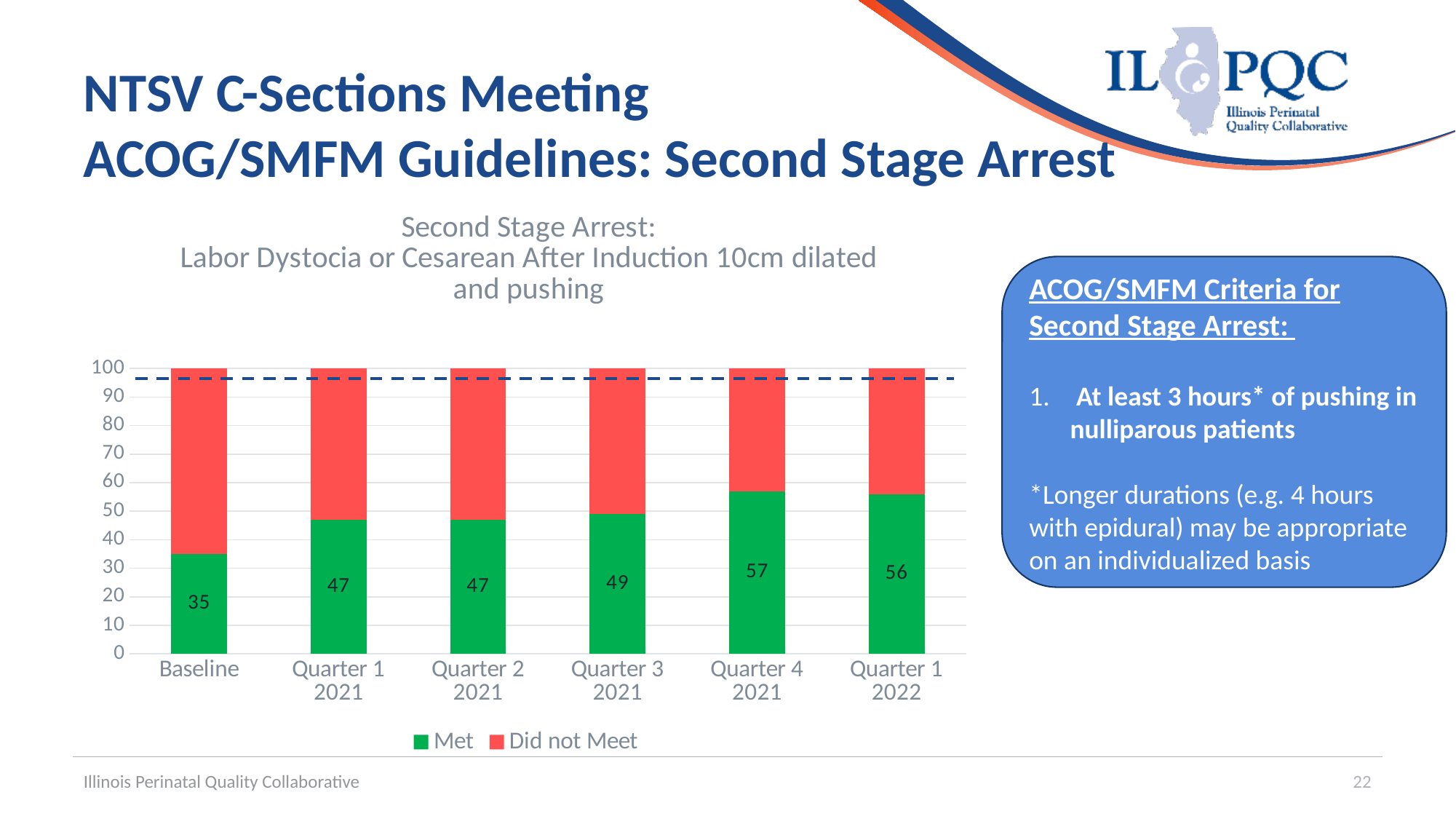
What kind of chart is shown on the slide? Stacked bar chart How many categories are shown on the x axis? 6 How many series does the legend list? 2 Is the Did not Meet value for Baseline greater or less than 60? greater Which category has the highest Met value? Quarter 4 2021 What is the Met value for Quarter 1 2022? 56 Which colour represents the Met series in the chart? Green What is the Met value for Quarter 4 2021? 57 Which category has the lowest Met value? Baseline What is the Met value for Baseline? 35 Is the Met value larger for Quarter 3 2021 or for Quarter 1 2021? Quarter 3 2021 What is the difference between the Met value for Quarter 4 2021 and the Met value for Baseline? 22